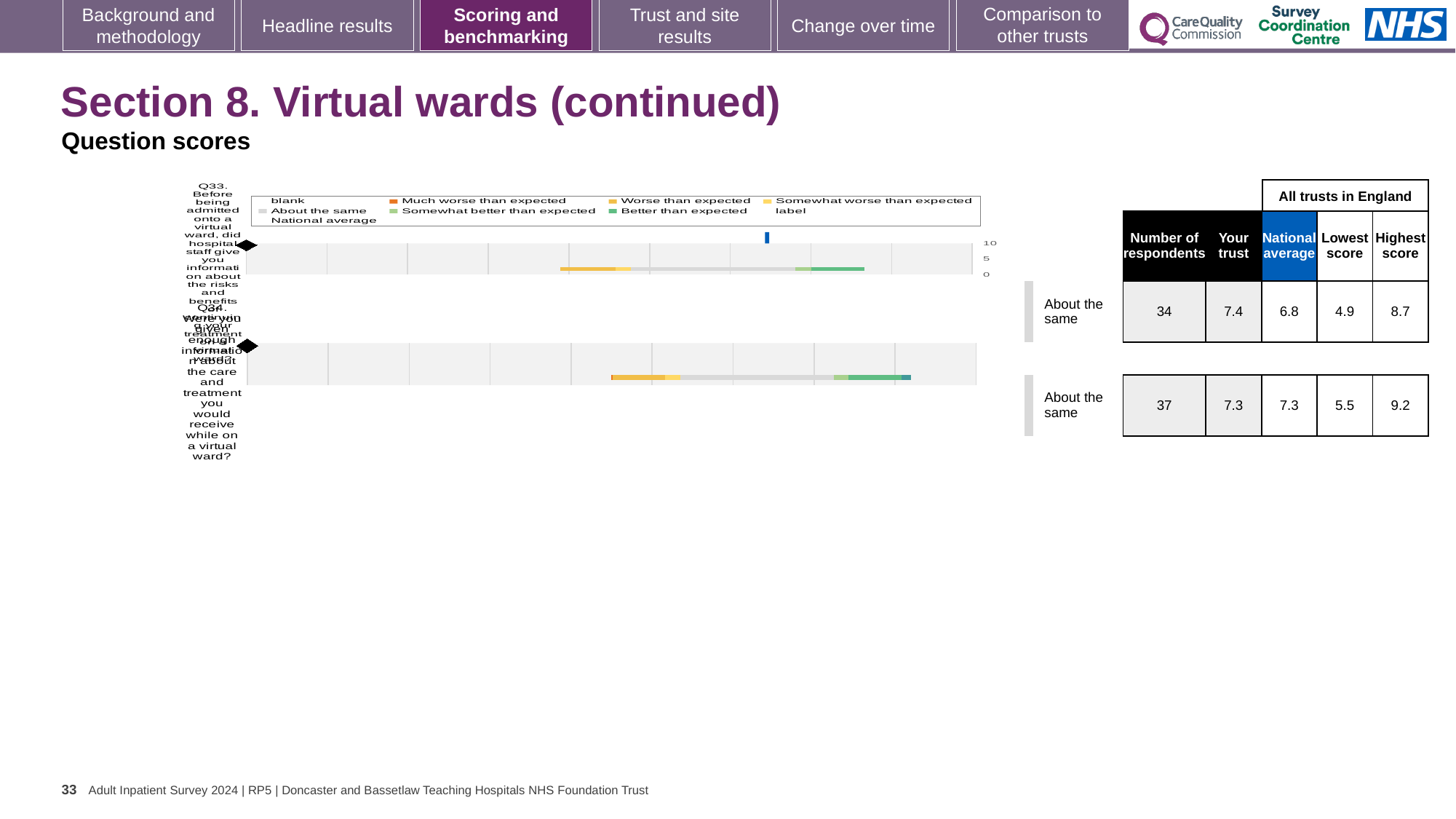
What is the highest score across all trusts in England for Q34? 9.2 For Q33, which is larger: the trust's score or the national average? Your trust What is the national average score for Q33? 6.8 How many questions are plotted on the slide? 2 Which question has the higher 'Highest score' across all trusts in England? Q34 What kind of chart is used to show the question scores? Bar chart By how much does the trust's score for Q33 exceed the national average? 0.6 How many respondents answered Q34? 37 What is the difference between the highest and lowest scores for Q34? 3.7 Which question had more respondents, Q33 or Q34? Q34 What is the 'Your trust' score for Q33? 7.4 What is the lowest score across all trusts in England for Q33? 4.9